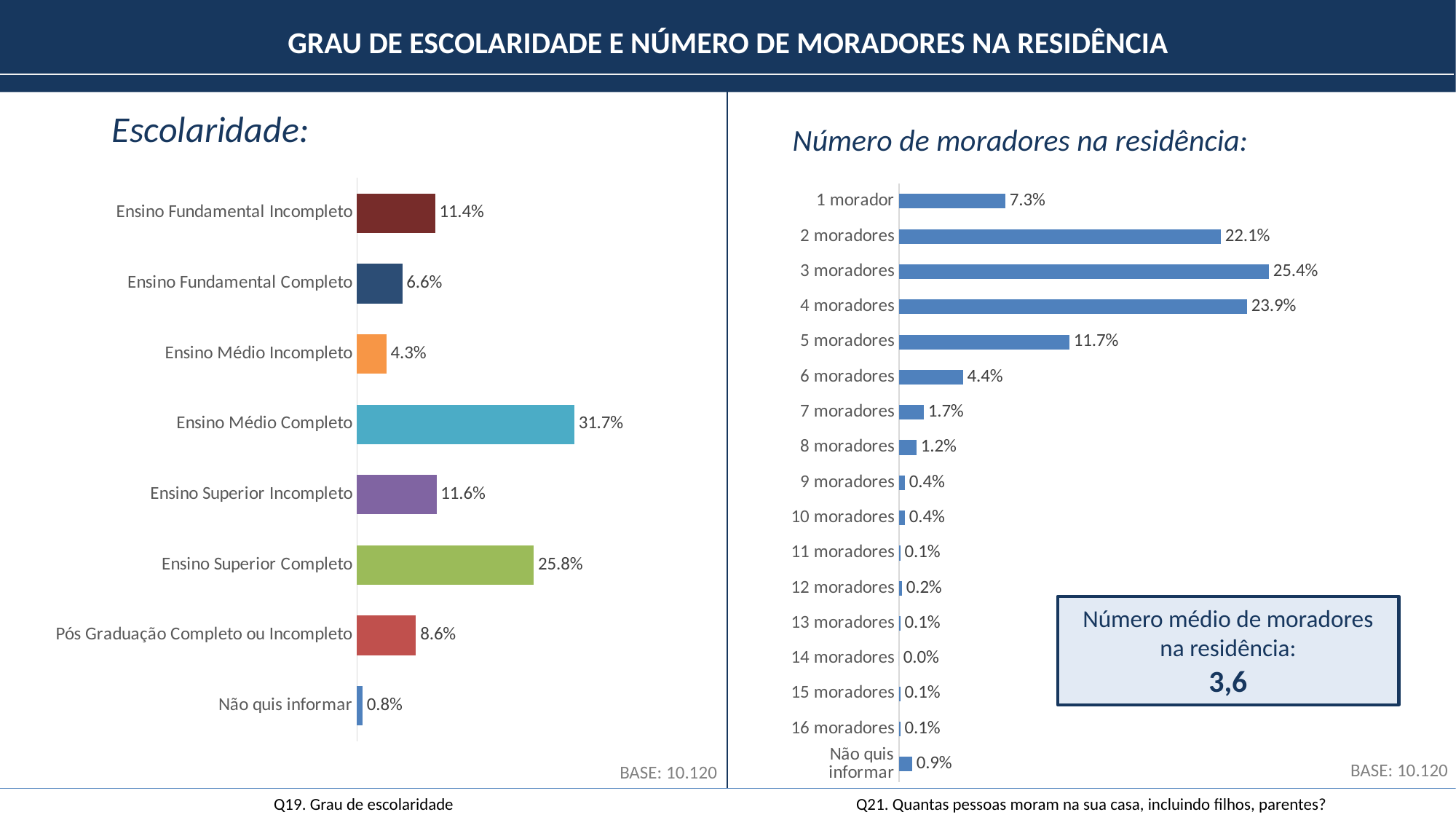
In the Escolaridade chart, which is larger: Ensino Fundamental Incompleto or Pós Graduação Completo ou Incompleto? Ensino Fundamental Incompleto In the Escolaridade chart, which category has the lowest value? Não quis informar In the Número de moradores na residência chart, which is larger: 5 moradores or 6 moradores? 5 moradores In the Número de moradores na residência chart, which category has the highest value? 3 moradores In the Escolaridade chart, what is the difference between Ensino Superior Completo and Ensino Superior Incompleto? 14.2% What is the average number of residents per household shown in the box on the right chart? 3,6 How many categories does the Número de moradores na residência chart show? 17 How many categories does the Escolaridade chart show? 8 In the Escolaridade chart, what is the value for Ensino Médio Completo? 31.7% In the Número de moradores na residência chart, what is the value for 4 moradores? 23.9% In the Número de moradores na residência chart, what is the difference between 2 moradores and 1 morador? 14.8% What kind of chart is the Escolaridade chart? Bar chart